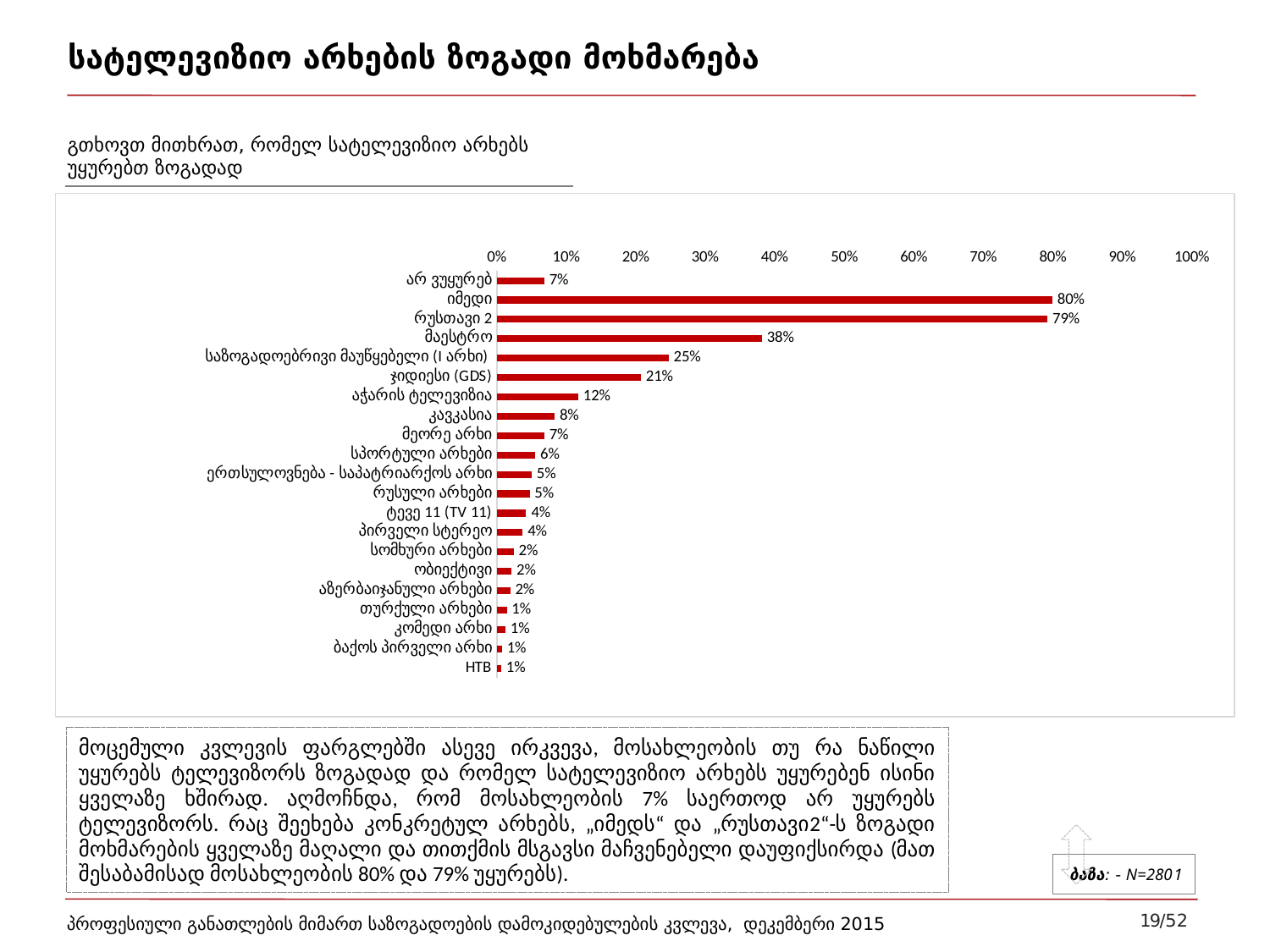
What is the value for იმედი? 80% Which is larger, the value for კავკასია or the value for აჭარის ტელევიზია? აჭარის ტელევიზია What is the difference between the values for მაესტრო and საზოგადოებრივი მაუწყებელი (I არხი)? 13% Is the value for რუსთავი 2 greater or less than 70%? greater How many categories are shown in the chart? 21 What is the value for HTB? 1% What is the value for მაესტრო? 38% What is the value for აჭარის ტელევიზია? 12% Which category has the highest value? იმედი What is the difference between the values for იმედი and რუსთავი 2? 1% What kind of chart is shown on the slide? bar chart What is the value for ჯიდიესი (GDS)? 21%